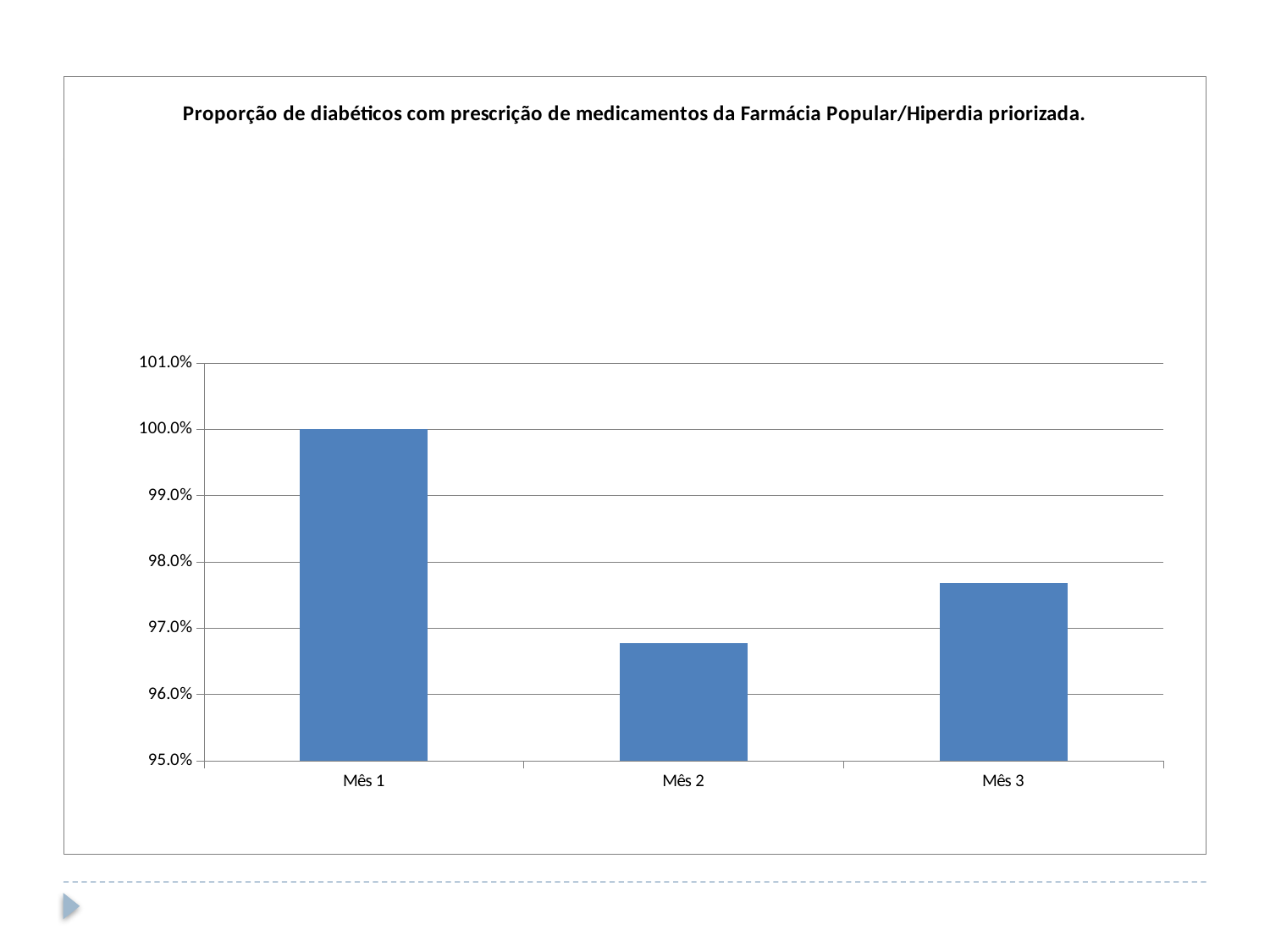
Which is larger, the value for Mês 2 or the value for Mês 3? Mês 3 What is the title of the chart? Proporção de diabéticos com prescrição de medicamentos da Farmácia Popular/Hiperdia priorizada. Which month has the lowest value? Mês 2 Does the value rise or fall from Mês 2 to Mês 3? rise How many months are shown on the x axis? 3 Is the value for Mês 3 greater or less than 97.0%? greater Which month has the highest value? Mês 1 Is the value for Mês 2 greater or less than 97.0%? less What kind of chart is shown on the slide? bar chart Is the value for Mês 3 greater or less than 98.0%? less Does the value rise or fall from Mês 1 to Mês 2? fall What is the value for Mês 1? 100.0%